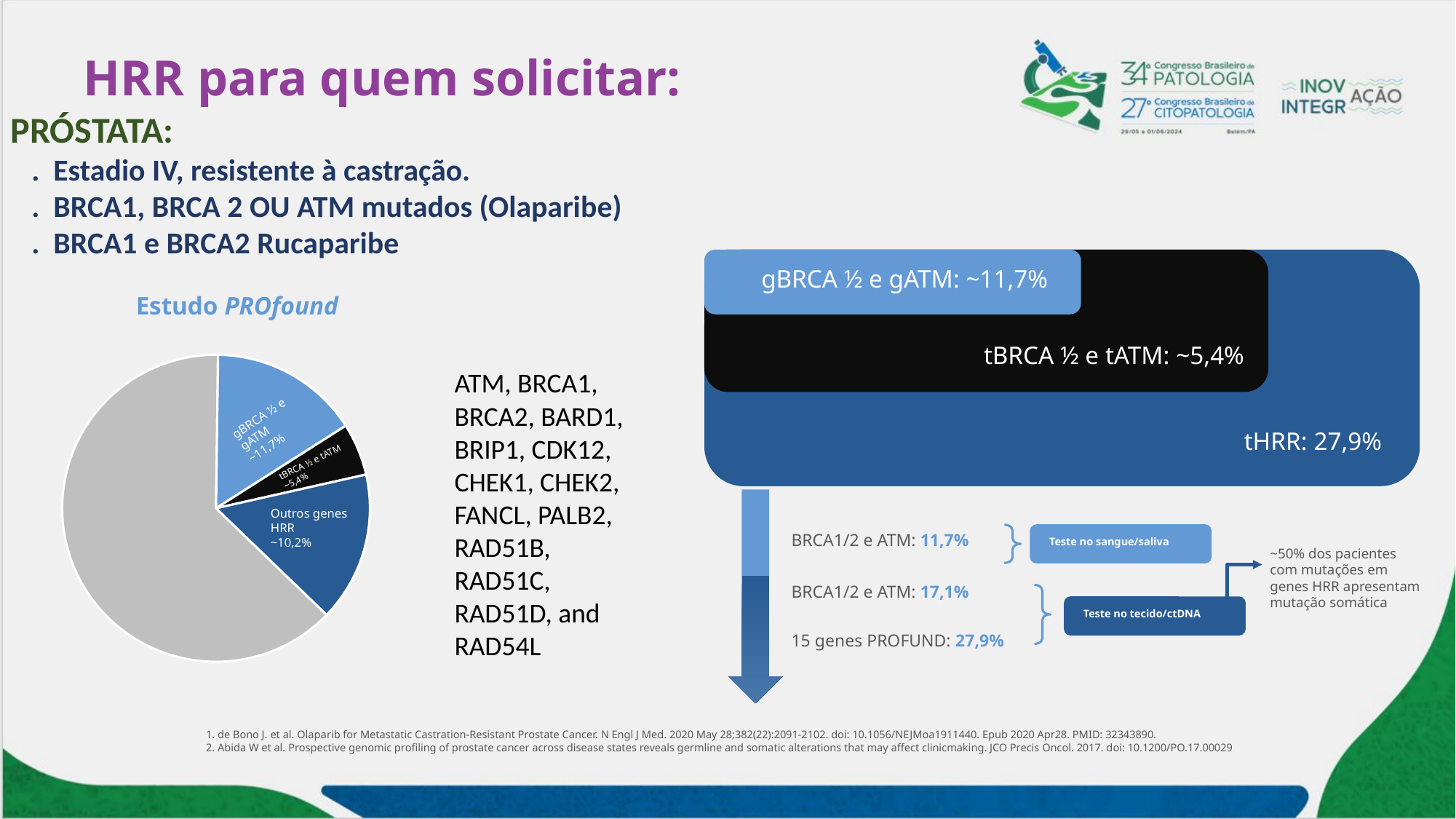
What colour is the 'tBRCA ½ e tATM' slice in the pie chart? black Among the labelled slices of the 'Estudo PROfound' pie chart, which has the largest value? gBRCA ½ e gATM In the 'Estudo PROfound' pie chart, what value is shown for the 'tBRCA ½ e tATM' slice? ~5,4% In the 'Estudo PROfound' pie chart, what value is shown for the 'gBRCA ½ e gATM' slice? ~11,7% In the 'Estudo PROfound' pie chart, what is the difference between the 'gBRCA ½ e gATM' value and the 'tBRCA ½ e tATM' value? 6,3% In the 'Estudo PROfound' pie chart, what value is shown for the 'Outros genes HRR' slice? ~10,2% What kind of chart is shown under the heading 'Estudo PROfound'? pie chart What is the title shown above the pie chart? Estudo PROfound How many labelled slices does the 'Estudo PROfound' pie chart have? 3 Among the labelled slices of the 'Estudo PROfound' pie chart, which has the smallest value? tBRCA ½ e tATM How many slices in total does the 'Estudo PROfound' pie chart have, including the unlabelled one? 4 In the 'Estudo PROfound' pie chart, which is larger: the 'gBRCA ½ e gATM' slice or the 'Outros genes HRR' slice? gBRCA ½ e gATM